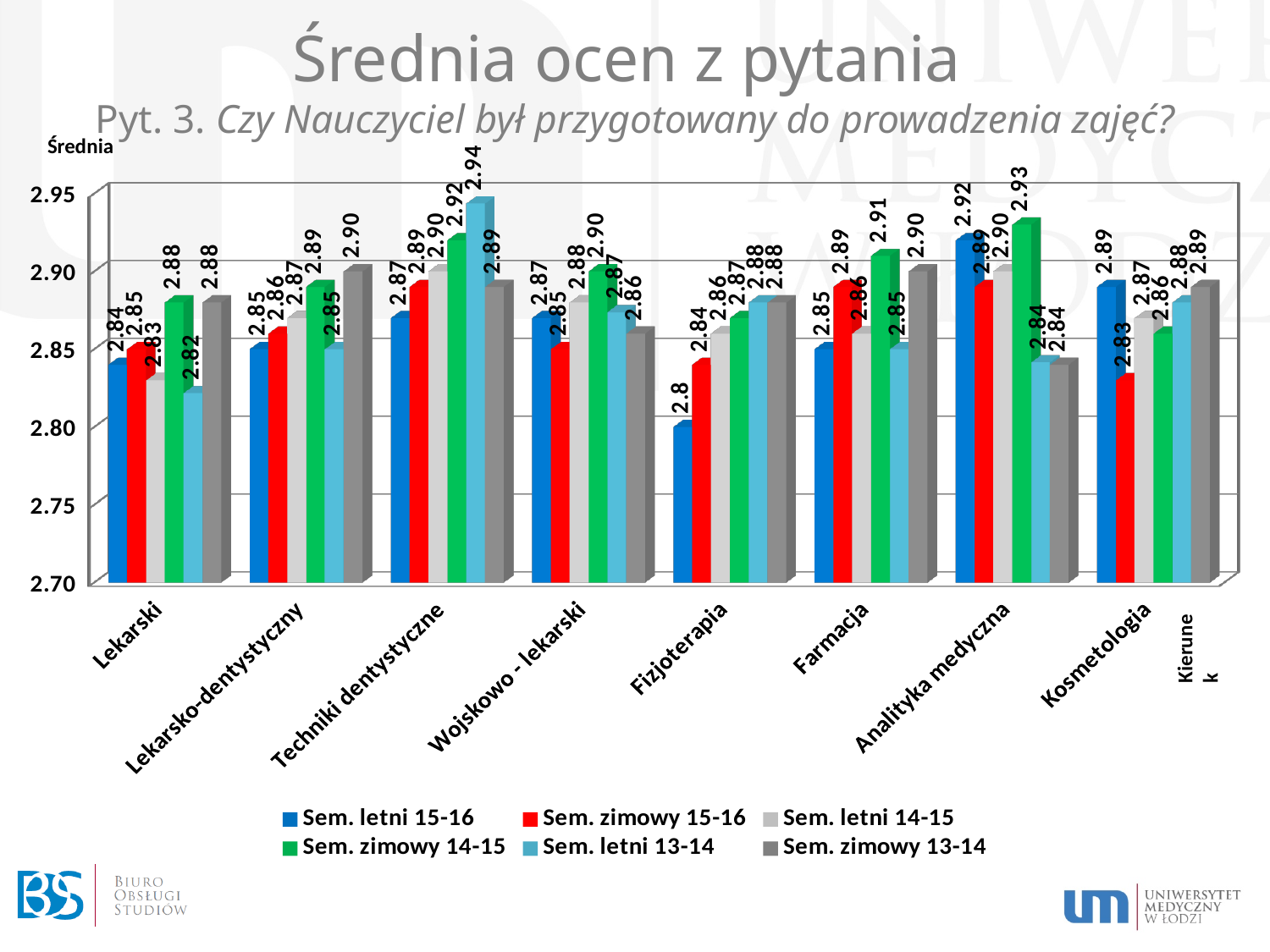
For Analityka medyczna, what is the difference between the Sem. zimowy 14-15 value and the Sem. letni 13-14 value? 0.09 Which category has the lowest value in the Sem. letni 15-16 series? Fizjoterapia How many categories are shown on the x axis of the chart? 8 Which category has the highest value in the Sem. letni 15-16 series? Analityka medyczna What is the value for Techniki dentystyczne in the Sem. letni 13-14 series? 2.94 What is the value for Fizjoterapia in the Sem. letni 15-16 series? 2.8 How many series does the legend list? 6 Is the value for Lekarski in the Sem. letni 13-14 series greater or less than 2.85? less For Kosmetologia, which is larger: the Sem. letni 15-16 value or the Sem. zimowy 15-16 value? Sem. letni 15-16 What is the value for Farmacja in the Sem. zimowy 14-15 series? 2.91 What colour represents the Sem. zimowy 14-15 series in the legend? green What kind of chart is shown on the slide? bar chart